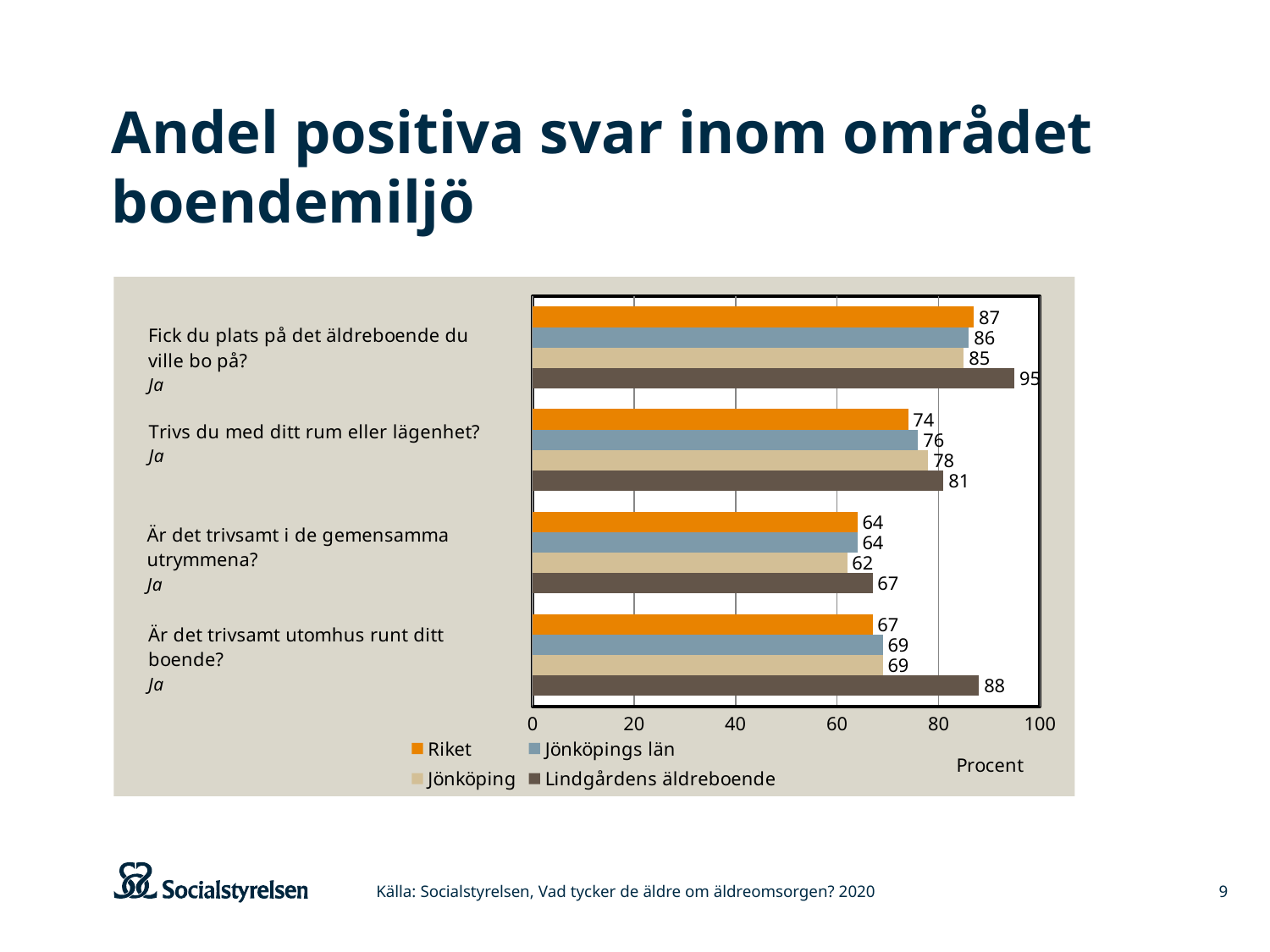
What is the value for Lindgårdens äldreboende for "Fick du plats på det äldreboende du ville bo på?"? 95 What kind of chart is shown on the slide? Bar chart How many questions (categories) are shown in the chart? 4 What is the value for Jönköping for "Är det trivsamt i de gemensamma utrymmena?"? 62 Which is larger for "Fick du plats på det äldreboende du ville bo på?": Riket or Jönköping? Riket Which series has the highest value for "Är det trivsamt utomhus runt ditt boende?"? Lindgårdens äldreboende What is the value for Jönköpings län for "Är det trivsamt utomhus runt ditt boende?"? 69 What is the difference between Lindgårdens äldreboende and Riket for "Är det trivsamt utomhus runt ditt boende?"? 21 Which series has the lowest value for "Trivs du med ditt rum eller lägenhet?"? Riket What is the value for Riket for "Trivs du med ditt rum eller lägenhet?"? 74 Is the value for Lindgårdens äldreboende for "Trivs du med ditt rum eller lägenhet?" greater or less than 80? greater How many series does the legend list? 4